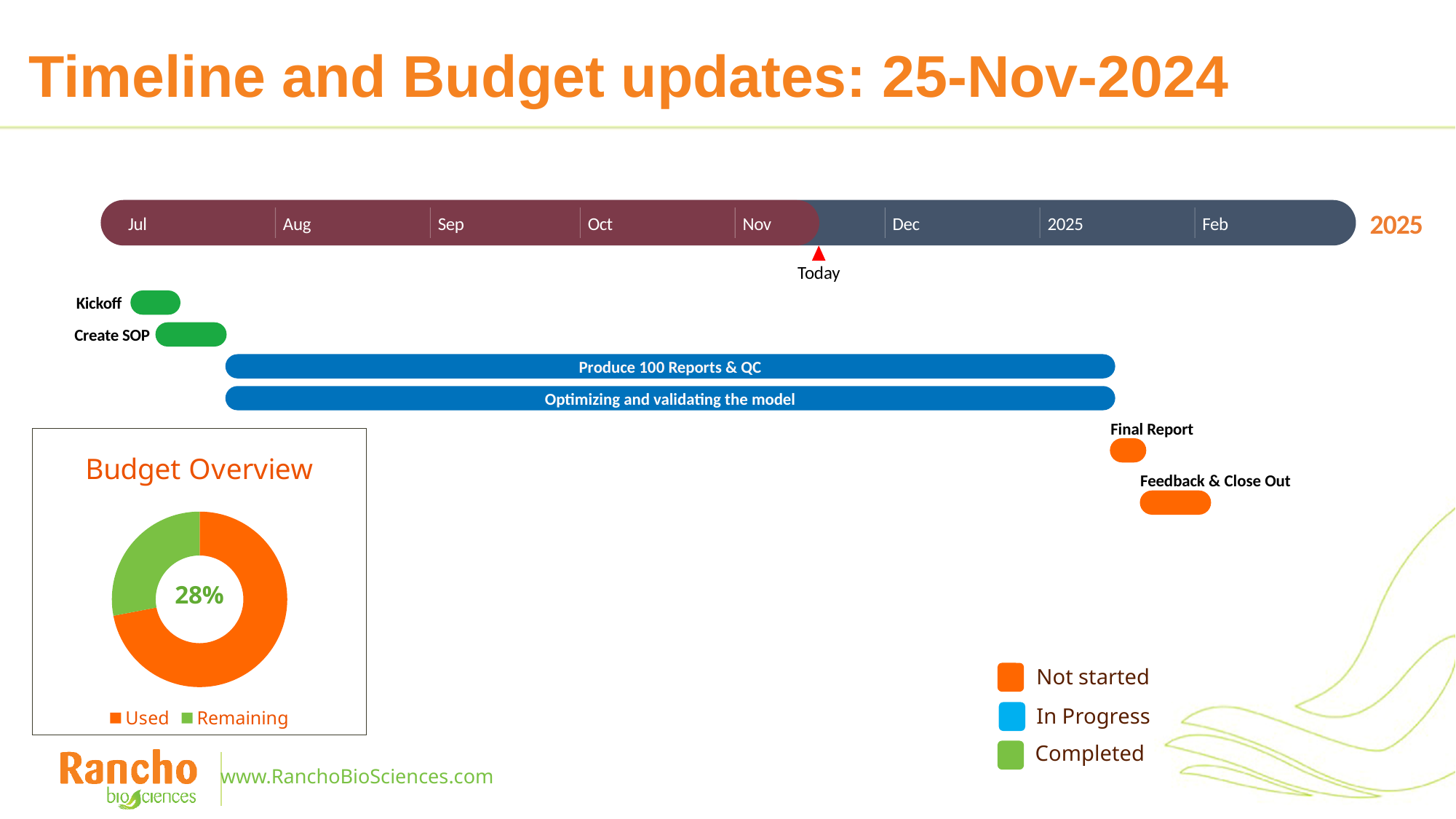
How many categories does the legend of the Budget Overview chart list? 2 In the Budget Overview chart, which category has the largest slice? Used In the Budget Overview chart, what share of the budget is Remaining? 28% In the Budget Overview chart, what colour represents the Remaining slice? green In the Budget Overview chart, which slice is larger, Used or Remaining? Used In the Budget Overview chart, is the Remaining share greater or less than 50%? less In the Budget Overview chart, which category has the smallest slice? Remaining What kind of chart is the Budget Overview chart? doughnut (pie) chart What is the title of the chart on the slide? Budget Overview